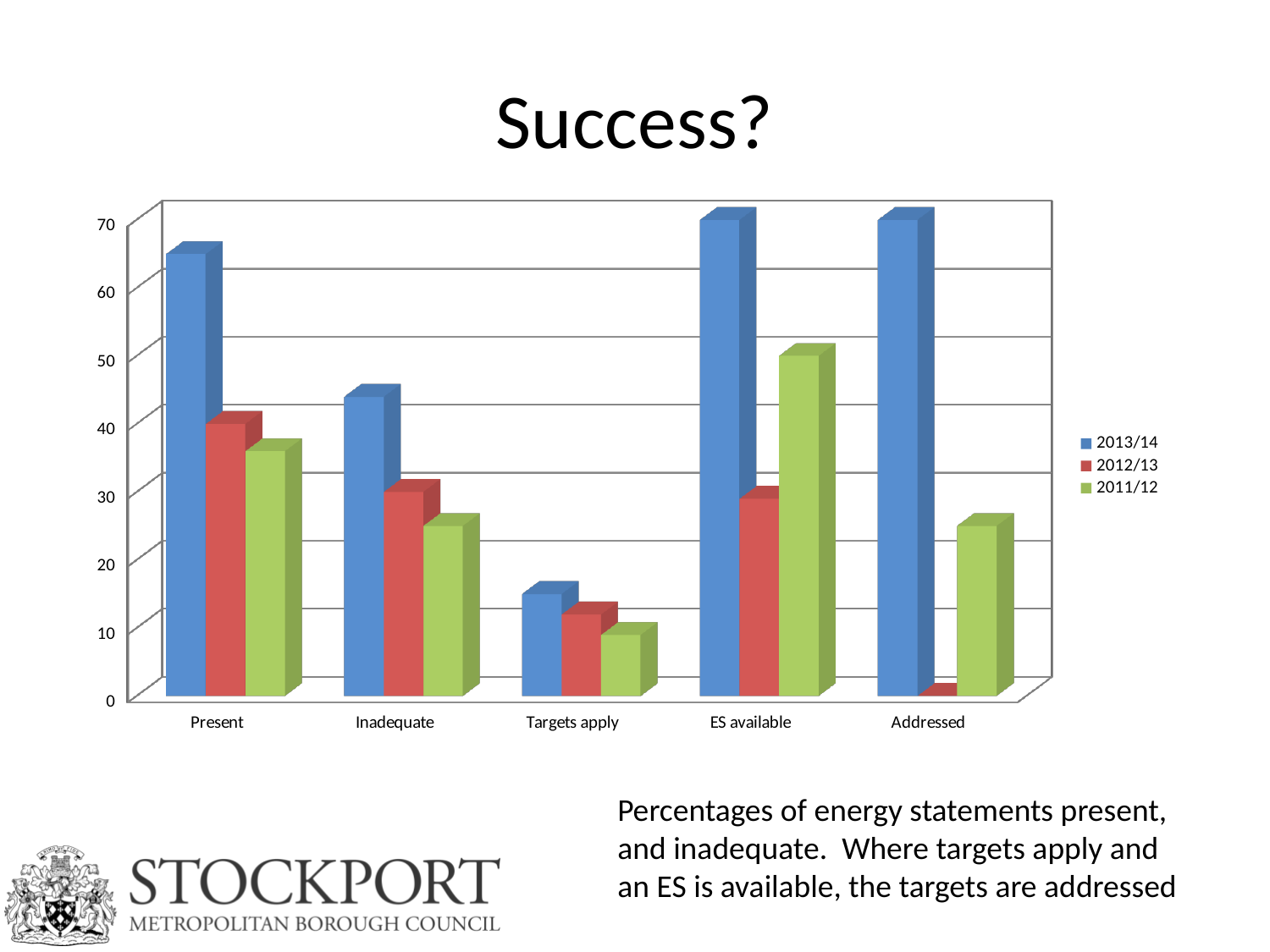
What kind of chart is shown on the slide? bar chart How many categories are shown on the x axis of the chart? 5 Which category has the lowest value for the 2013/14 series? Targets apply Which category has the highest value for the 2011/12 series? ES available Which category has the highest value for the 2012/13 series? Present Is the value for Present in the 2013/14 series greater or less than 60? greater Which category has the lowest value for the 2012/13 series? Addressed For the ES available category, which series has the larger value, 2011/12 or 2012/13? 2011/12 How many series does the chart's legend list? 3 Is the value for Addressed in the 2012/13 series greater or less than 10? less Which series are listed in the chart's legend? 2013/14, 2012/13, 2011/12 Is the value for ES available in the 2011/12 series greater or less than 40? greater